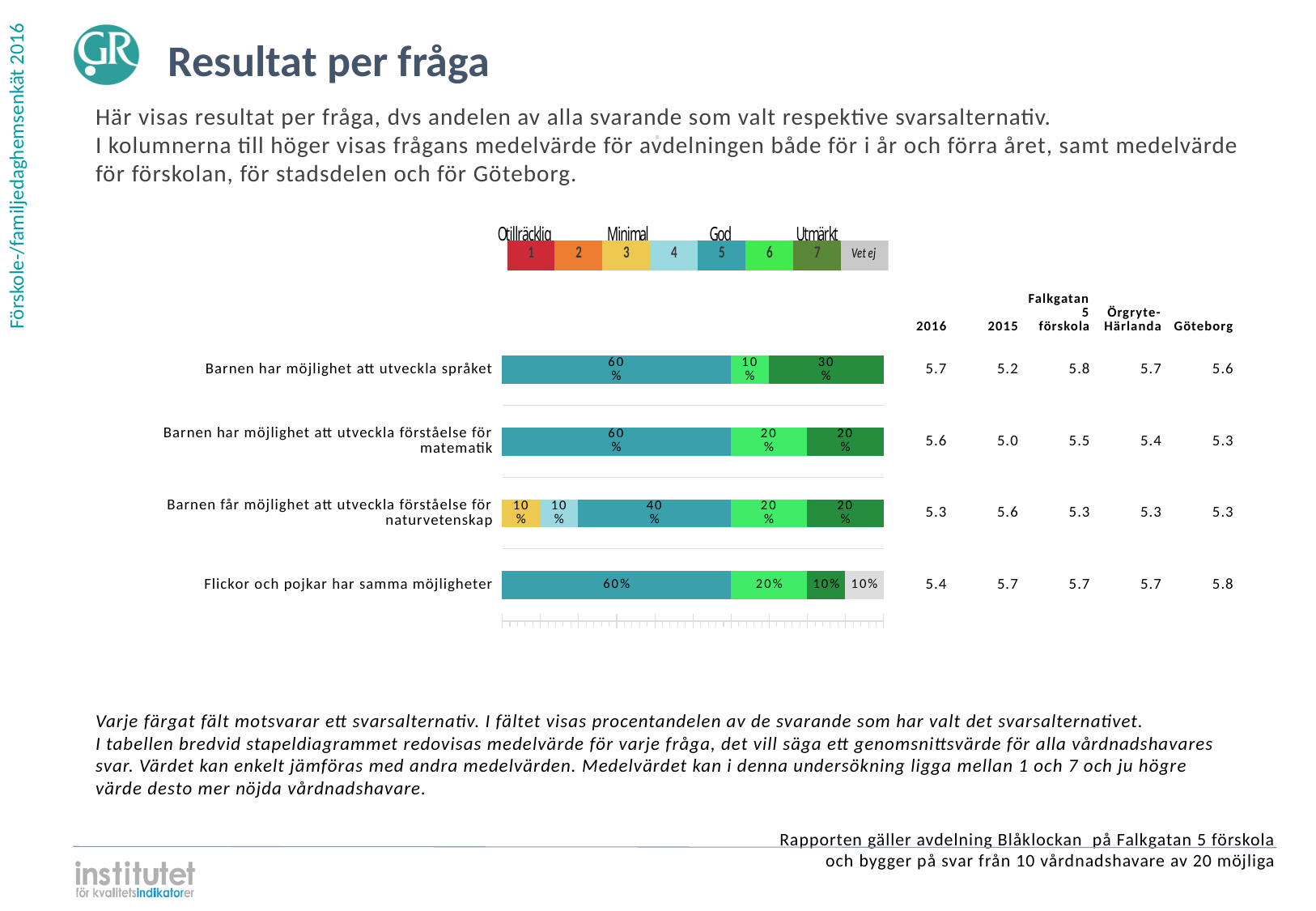
How many questions (categories) are plotted in the bar chart? 4 What percentage of respondents chose answer 5 (God) for 'Barnen får möjlighet att utveckla förståelse för naturvetenskap'? 40% Which question has the smallest share of respondents choosing answer 5 (God)? Barnen får möjlighet att utveckla förståelse för naturvetenskap What is the difference between the share choosing answer 7 for 'Barnen har möjlighet att utveckla språket' and the share choosing answer 7 for 'Flickor och pojkar har samma möjligheter'? 20% How many answer alternatives does the legend above the chart list, including 'Vet ej'? 8 What percentage of respondents chose answer 7 (Utmärkt) for 'Barnen har möjlighet att utveckla språket'? 30% Which question has the largest share of respondents choosing answer 7 (Utmärkt)? Barnen har möjlighet att utveckla språket What percentage of respondents answered 'Vet ej' for 'Flickor och pojkar har samma möjligheter'? 10% What is the combined share of answers 6 and 7 for 'Barnen har möjlighet att utveckla förståelse för matematik'? 40% Is the share choosing answer 6 larger for 'Barnen har möjlighet att utveckla förståelse för matematik' or for 'Barnen har möjlighet att utveckla språket'? Barnen har möjlighet att utveckla förståelse för matematik What is the 2016 mean value shown for 'Barnen har möjlighet att utveckla språket'? 5.7 What kind of chart is shown on the slide? Stacked bar chart